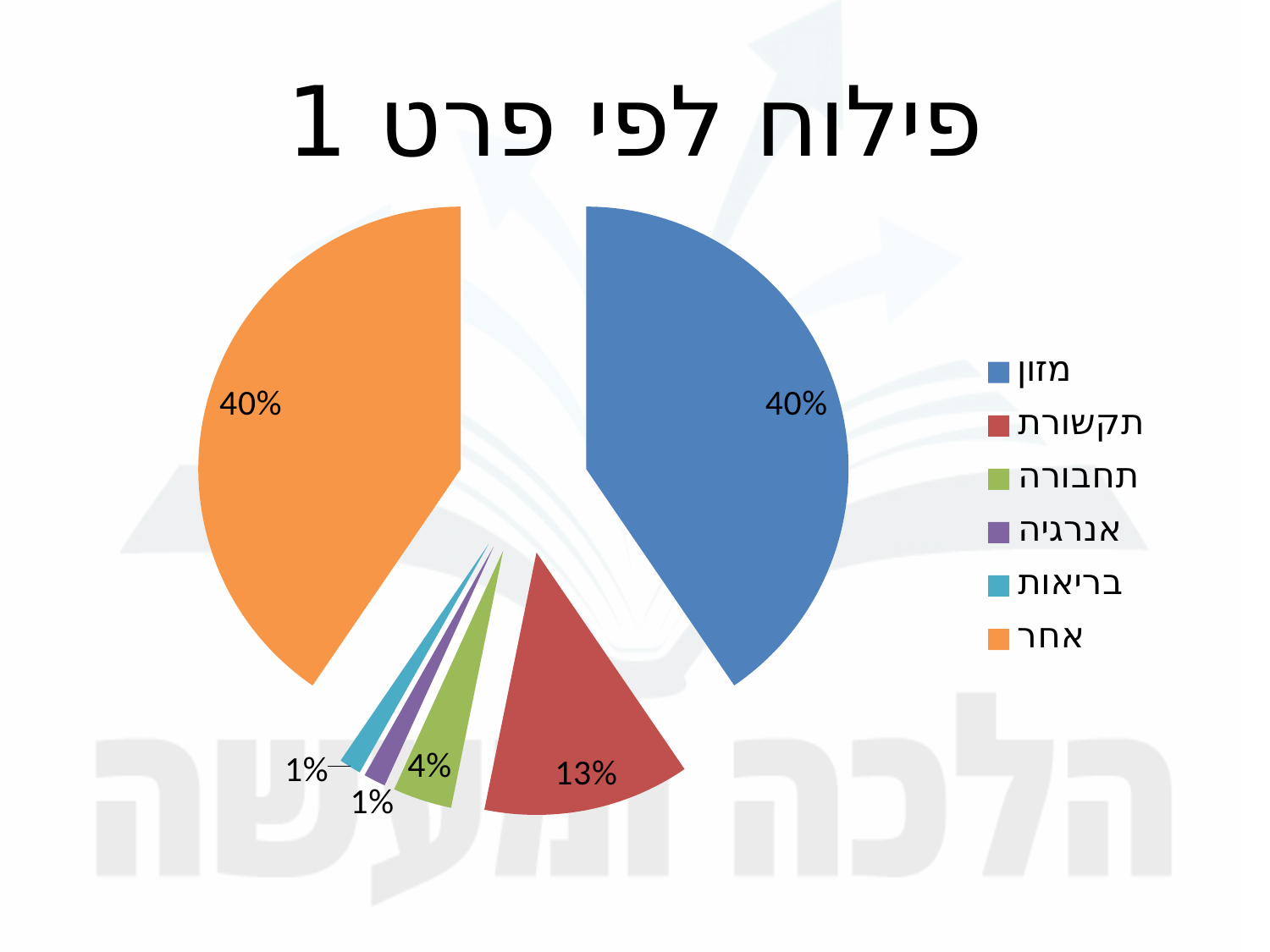
What share of the pie does תחבורה have? 4% What share of the pie does מזון have? 40% Which is larger, the share for תחבורה or the share for בריאות? תחבורה What is the title of the chart? פילוח לפי פרט 1 What share of the pie does תקשורת have? 13% Which is larger, the share for מזון or the share for תקשורת? מזון Which colour represents תקשורת in the legend? red What is the difference between the share for אחר and the share for תקשורת? 27% How many slices does the pie chart have? 6 What kind of chart is shown on the slide? pie chart